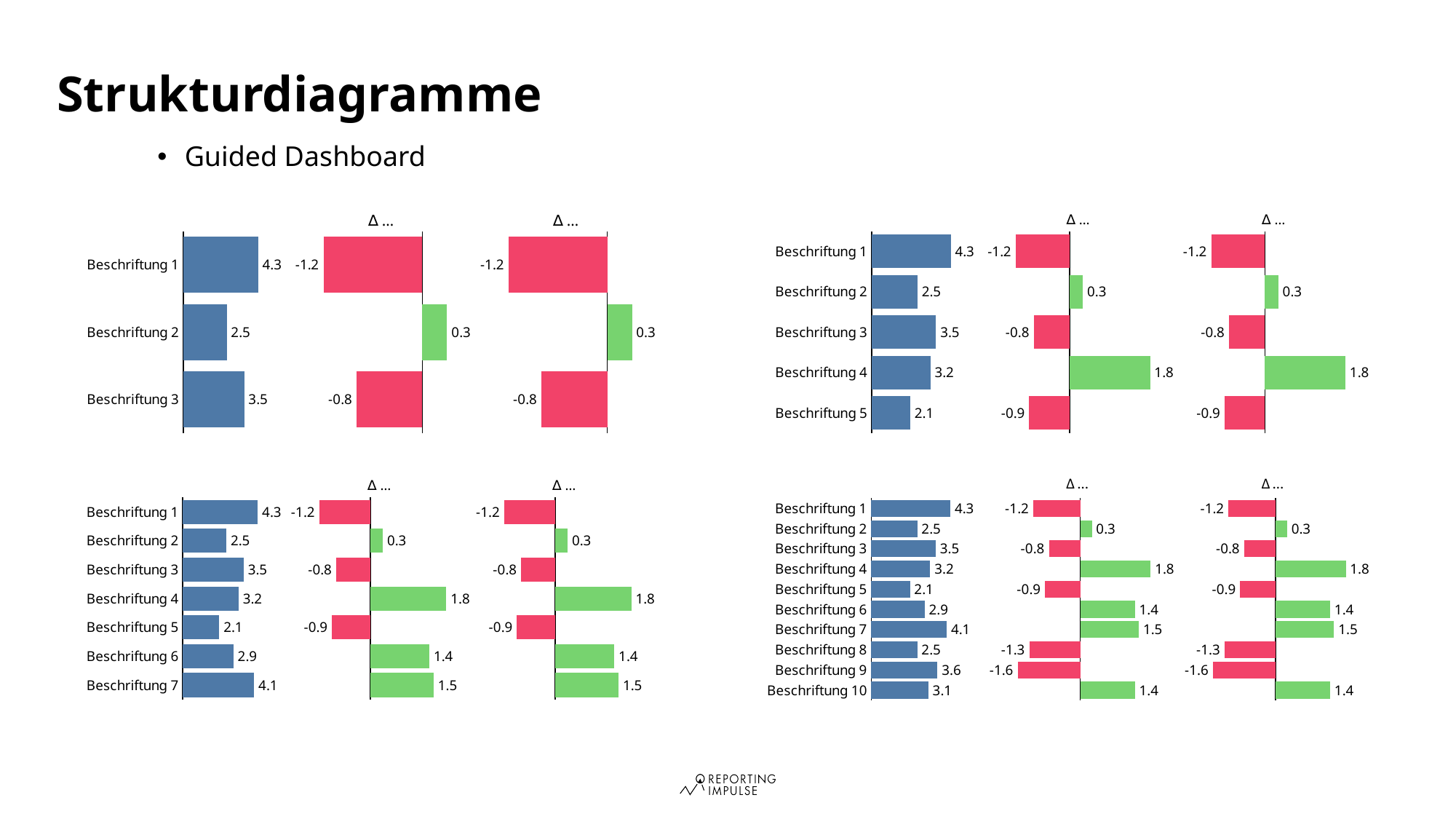
In the bottom-right chart, what is the Δ value for Beschriftung 9? -1.6 How many categories does the bottom-left chart show? 7 What type of chart is used on this slide? Bar chart In the top-right chart, which category has the highest blue bar value? Beschriftung 1 In the bottom-left chart, which category has the lowest blue bar value? Beschriftung 5 In the top-left chart, what is the first Δ value for Beschriftung 3? -0.8 In the bottom-left chart, what is the difference between the blue bar values of Beschriftung 7 and Beschriftung 6? 1.2 How many categories does the bottom-right chart show? 10 In the top-right chart, what is the Δ value for Beschriftung 4? 1.8 In the bottom-right chart, which is larger: the blue bar value for Beschriftung 9 or for Beschriftung 10? Beschriftung 9 How many categories does the top-right chart show? 5 In the top-left chart, what is the value for Beschriftung 2 in the blue bar series? 2.5